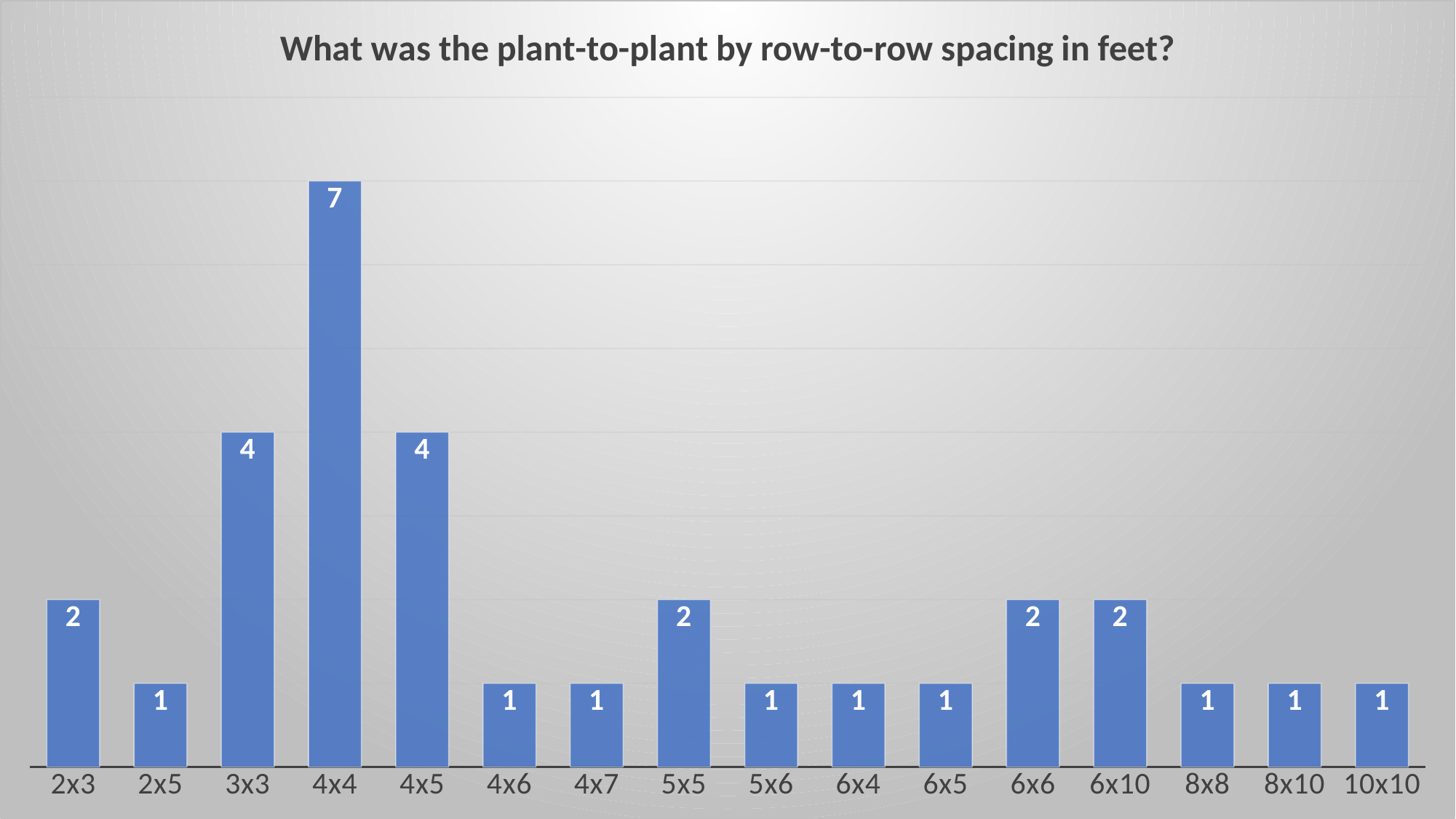
What is the title of the chart? What was the plant-to-plant by row-to-row spacing in feet? Which has a larger value, 5x5 or 5x6? 5x5 What is the value for the 3x3 spacing category? 4 What is the difference between the values for 2x3 and 2x5? 1 How many spacing categories are shown on the x axis? 16 What is the value for the 4x4 spacing category? 7 What is the difference between the values for 4x4 and 4x5? 3 What is the value for the 8x8 spacing category? 1 Which spacing category has the highest value? 4x4 What is the value for the 6x10 spacing category? 2 What kind of chart is shown on the slide? Bar chart Which has a larger value, 3x3 or 6x6? 3x3